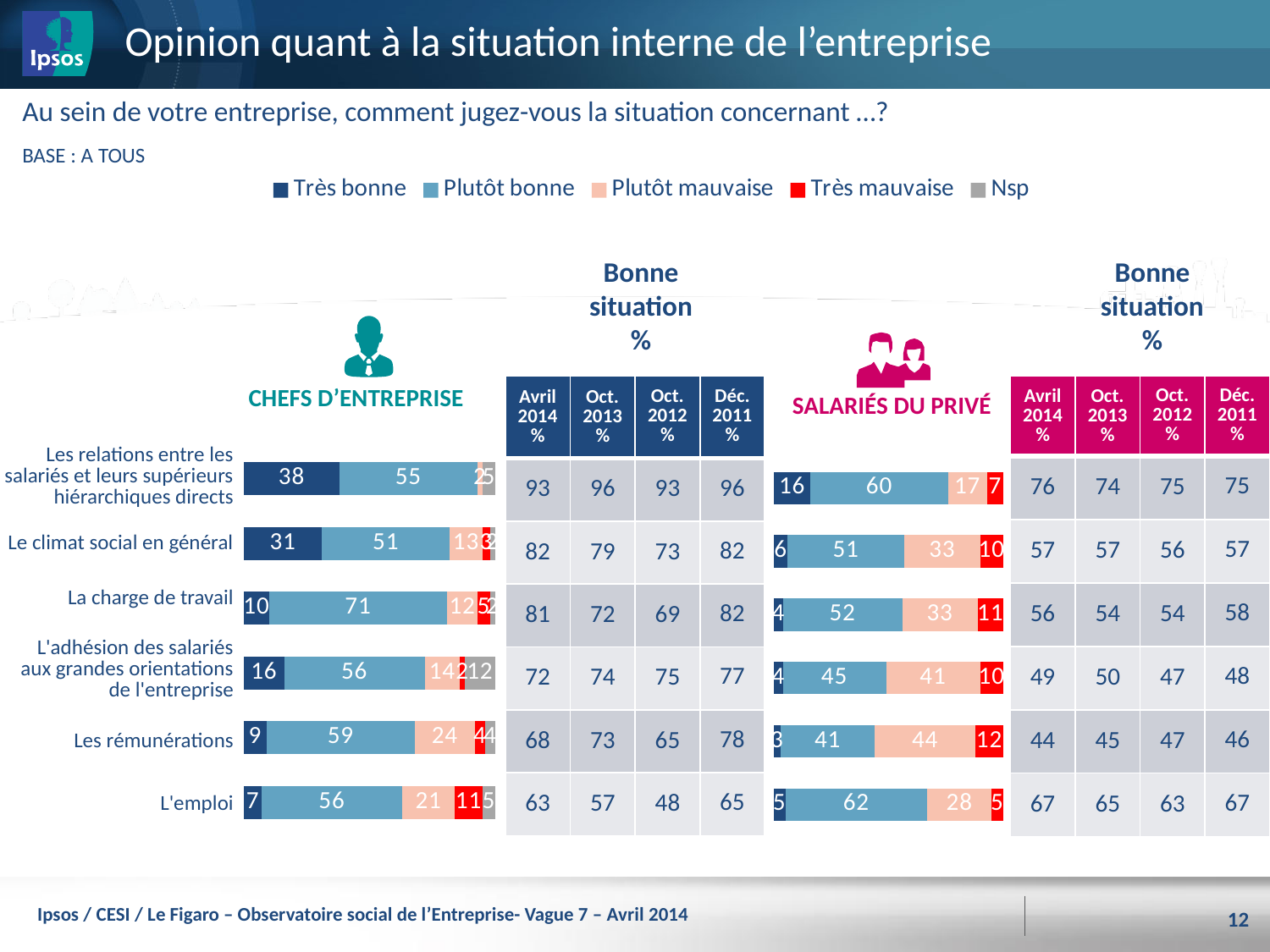
In the SALARIÉS DU PRIVÉ chart, what is the 'Plutôt bonne' value for 'L'emploi'? 62 In the CHEFS D'ENTREPRISE chart, what is the 'Très bonne' value for 'Les relations entre les salariés et leurs supérieurs hiérarchiques directs'? 38 In the SALARIÉS DU PRIVÉ chart, what is the difference between the 'Plutôt bonne' values for 'Les relations entre les salariés et leurs supérieurs hiérarchiques directs' and 'Le climat social en général'? 9 Which colour represents 'Très mauvaise' in the legend? Red How many series does the legend list? 5 In the CHEFS D'ENTREPRISE chart, which is larger: the 'Plutôt bonne' value for 'Les rémunérations' or for 'L'emploi'? Les rémunérations How many categories does the CHEFS D'ENTREPRISE chart show? 6 What kind of chart is the SALARIÉS DU PRIVÉ chart? Stacked bar chart In the CHEFS D'ENTREPRISE chart, which category has the highest 'Très bonne' value? Les relations entre les salariés et leurs supérieurs hiérarchiques directs In the SALARIÉS DU PRIVÉ chart, which category has the lowest 'Plutôt bonne' value? Les rémunérations In the CHEFS D'ENTREPRISE chart, what is the 'Plutôt bonne' value for 'La charge de travail'? 71 In the SALARIÉS DU PRIVÉ chart, what is the 'Plutôt mauvaise' value for 'Les rémunérations'? 44